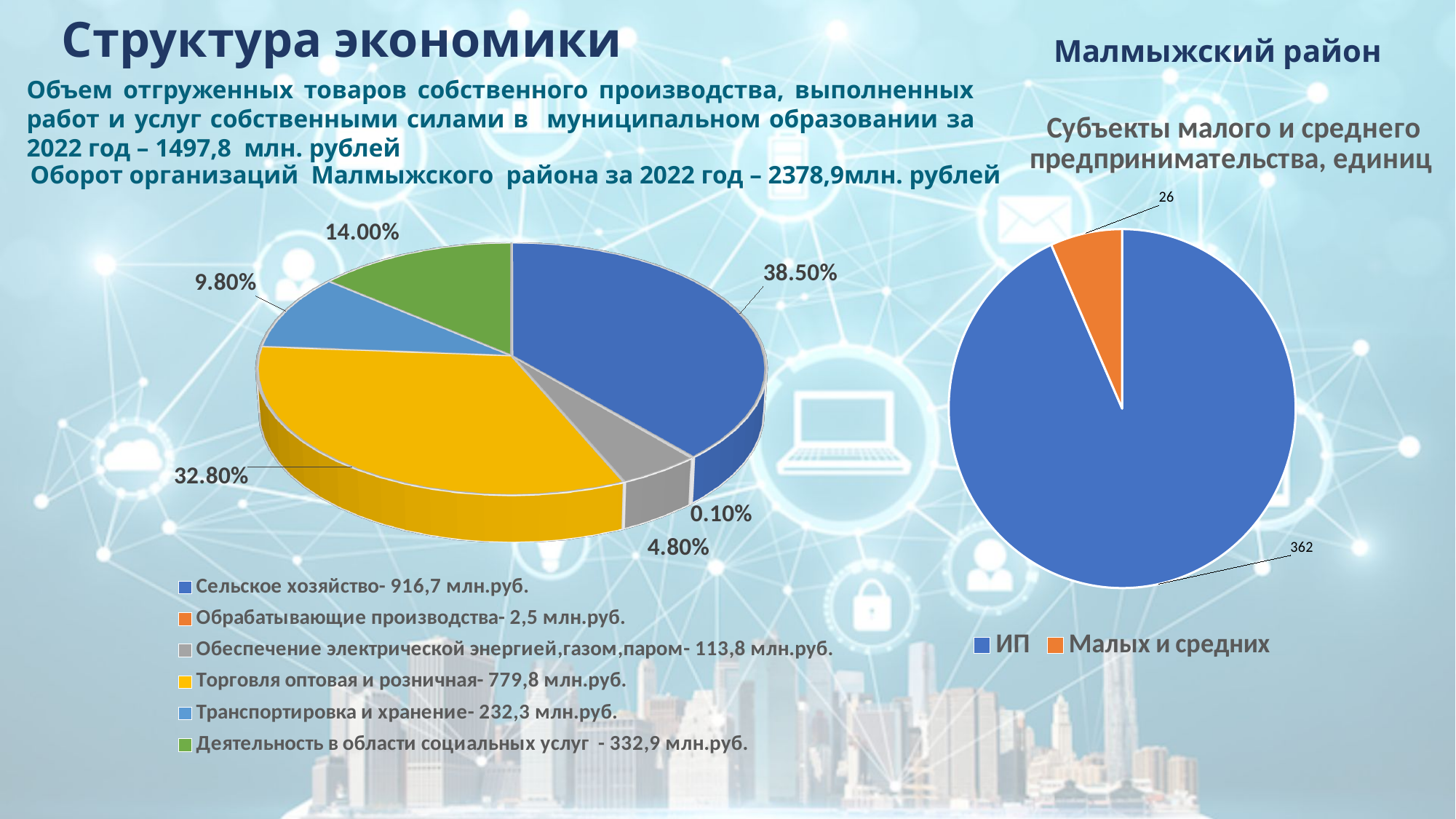
On the chart titled 'Субъекты малого и среднего предпринимательства, единиц', what is the value for ИП? 362 On the left pie chart, which category has the largest share? Сельское хозяйство On the chart titled 'Субъекты малого и среднего предпринимательства, единиц', what is the value for Малых и средних? 26 On the left pie chart, what percentage share does Торговля оптовая и розничная have? 32.80% On the left pie chart, what is the difference in percentage points between Сельское хозяйство and Торговля оптовая и розничная? 5.70 On the left pie chart, which category has the smallest share? Обрабатывающие производства On the left pie chart, what percentage share does Транспортировка и хранение have? 9.80% How many categories does the legend of the left pie chart list? 6 On the chart titled 'Субъекты малого и среднего предпринимательства, единиц', what is the difference between ИП and Малых и средних? 336 On the left pie chart, what percentage share does Сельское хозяйство have? 38.50% On the left pie chart, which is larger: Деятельность в области социальных услуг or Транспортировка и хранение? Деятельность в области социальных услуг What type of chart is the one titled 'Субъекты малого и среднего предпринимательства, единиц'? Pie chart